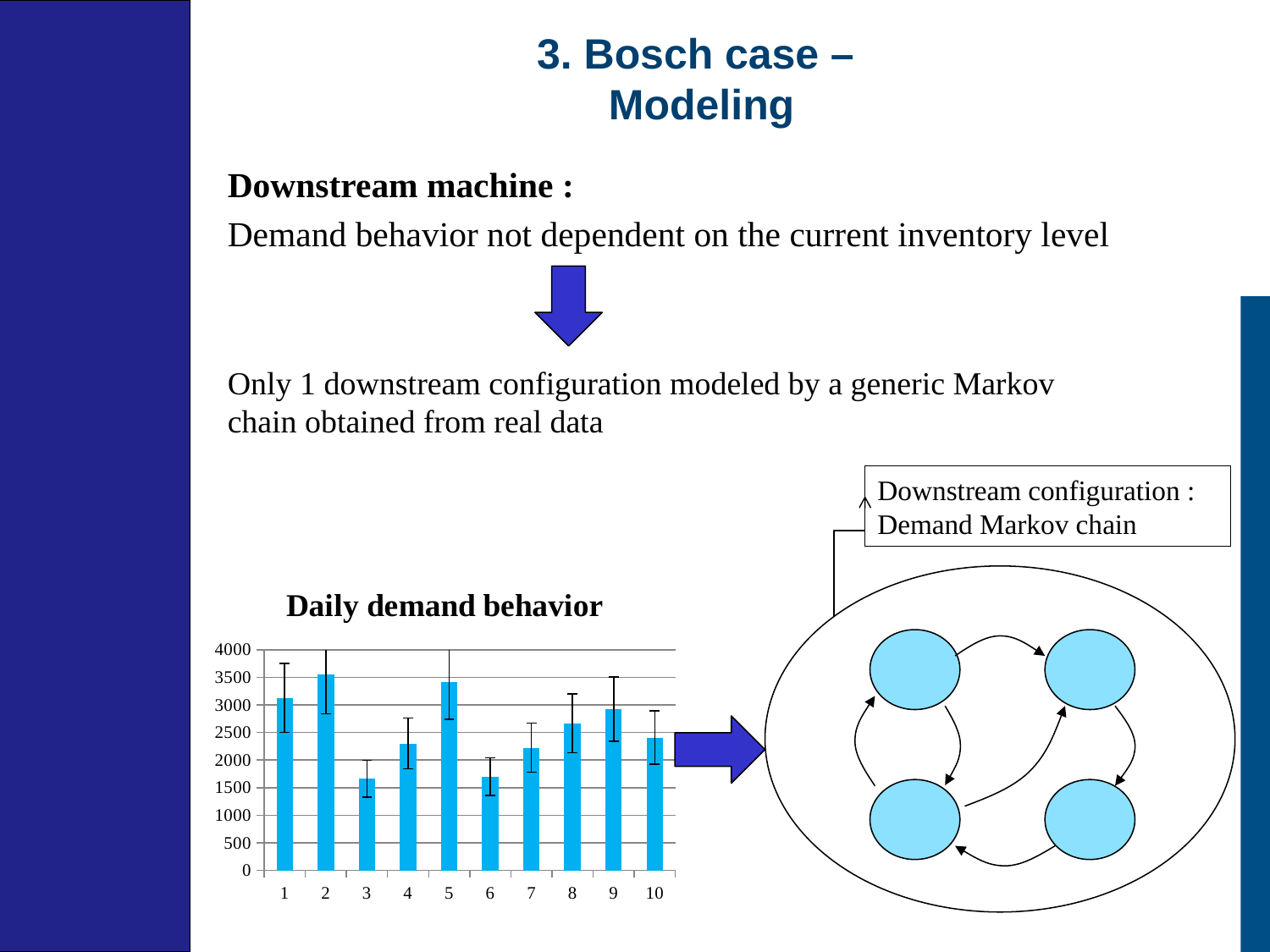
How many categories are plotted on the x axis of the Daily demand behavior chart? 10 Is the value for category 4 greater or less than 2000? greater Is the value for category 6 greater or less than 2000? less What type of chart is shown on the slide? bar chart Which has the larger value, category 2 or category 3? 2 What is the title of the chart on the slide? Daily demand behavior Is the value for category 8 greater or less than 2500? greater What is the highest value shown on the y axis of the chart? 4000 Which category has the highest bar in the Daily demand behavior chart? 2 Which has the larger value, category 5 or category 4? 5